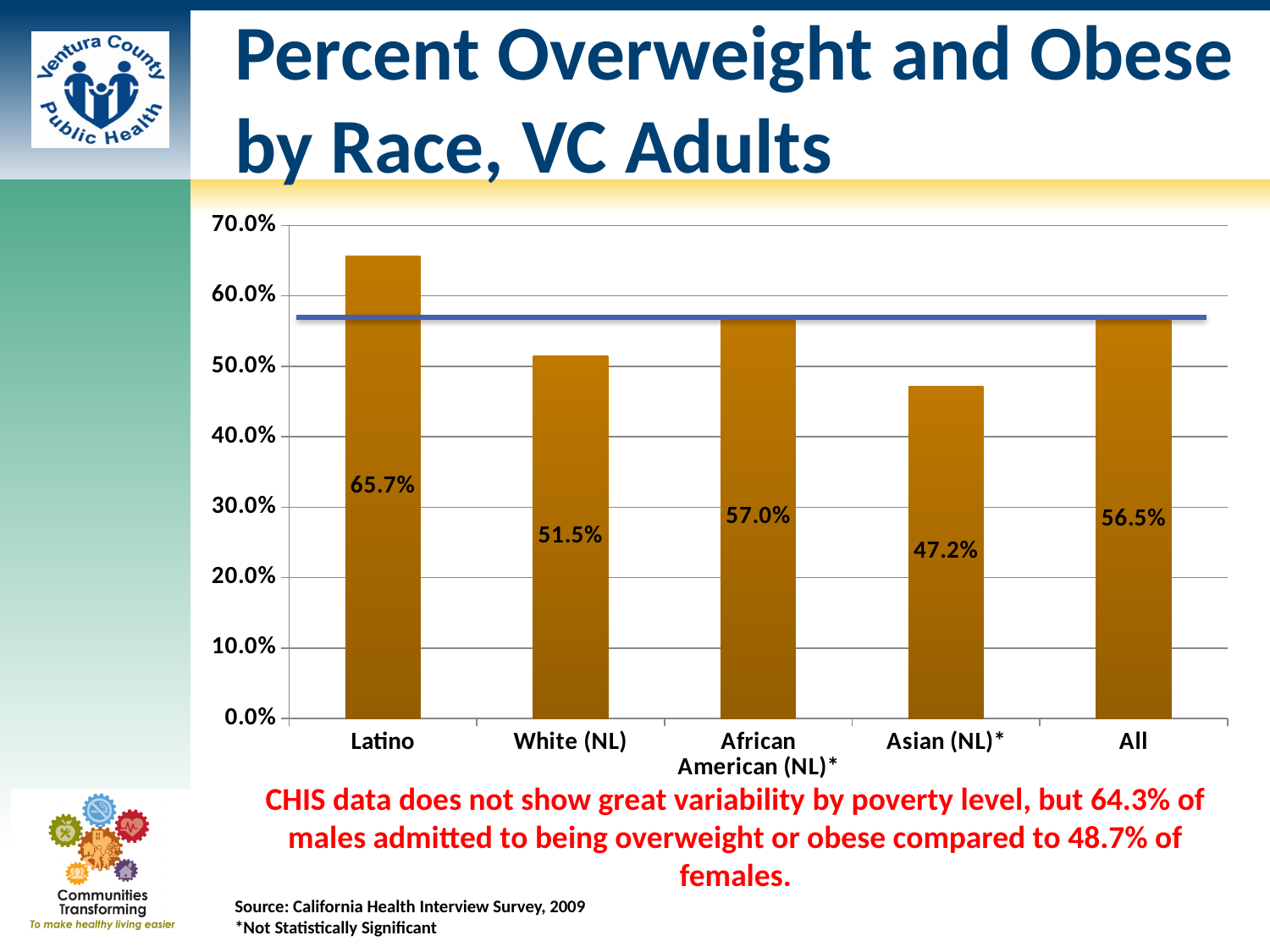
What kind of chart is shown on the slide? Bar chart Which race category has the highest percent overweight and obese? Latino What is the value shown for White (NL)? 51.5% Is the value for Asian (NL)* greater or less than 50.0%? less What is the source cited for the chart data? California Health Interview Survey, 2009 What is the value shown for Asian (NL)*? 47.2% How many categories are shown on the x axis? 5 Which is larger, the value for African American (NL)* or the value for All? African American (NL)* What is the percent overweight and obese for Latino adults? 65.7% What is the value shown for the All category? 56.5% What is the difference between the Latino value and the White (NL) value? 14.2% Which race category has the lowest percent overweight and obese? Asian (NL)*